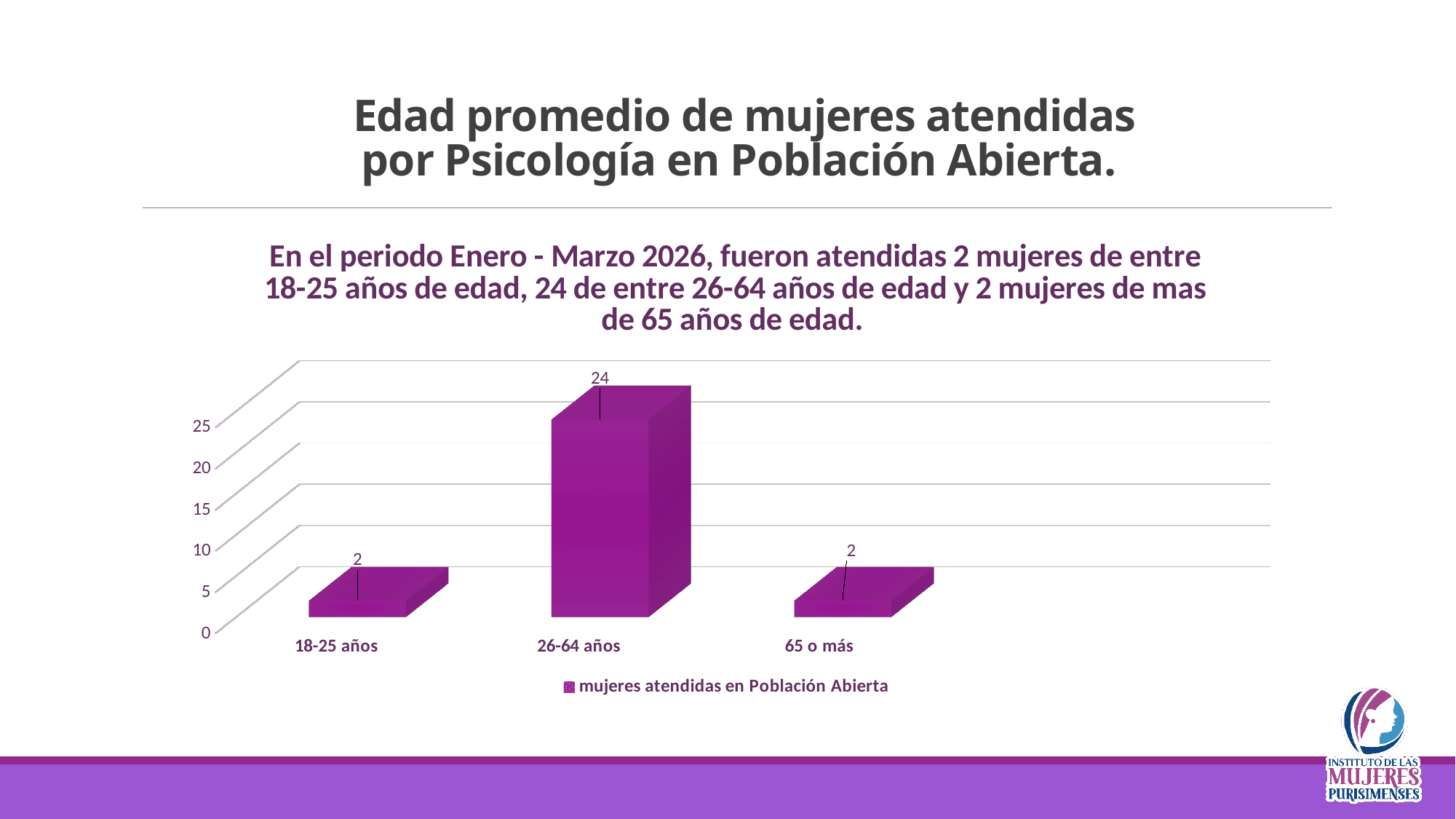
Which is larger, the value for 26-64 años or the value for 65 o más? 26-64 años What is the difference between the values for 26-64 años and 18-25 años? 22 What is the value for the 18-25 años category? 2 What is the value for the 26-64 años category? 24 What kind of chart is shown on the slide? bar chart What is the value for the 65 o más category? 2 What is the legend entry for the series shown in the chart? mujeres atendidas en Población Abierta How many age categories are shown on the x axis? 3 Is the value for 18-25 años greater or less than 5? less Is the value for 26-64 años greater or less than 20? greater Which age category has the highest value? 26-64 años How many series does the legend list? 1